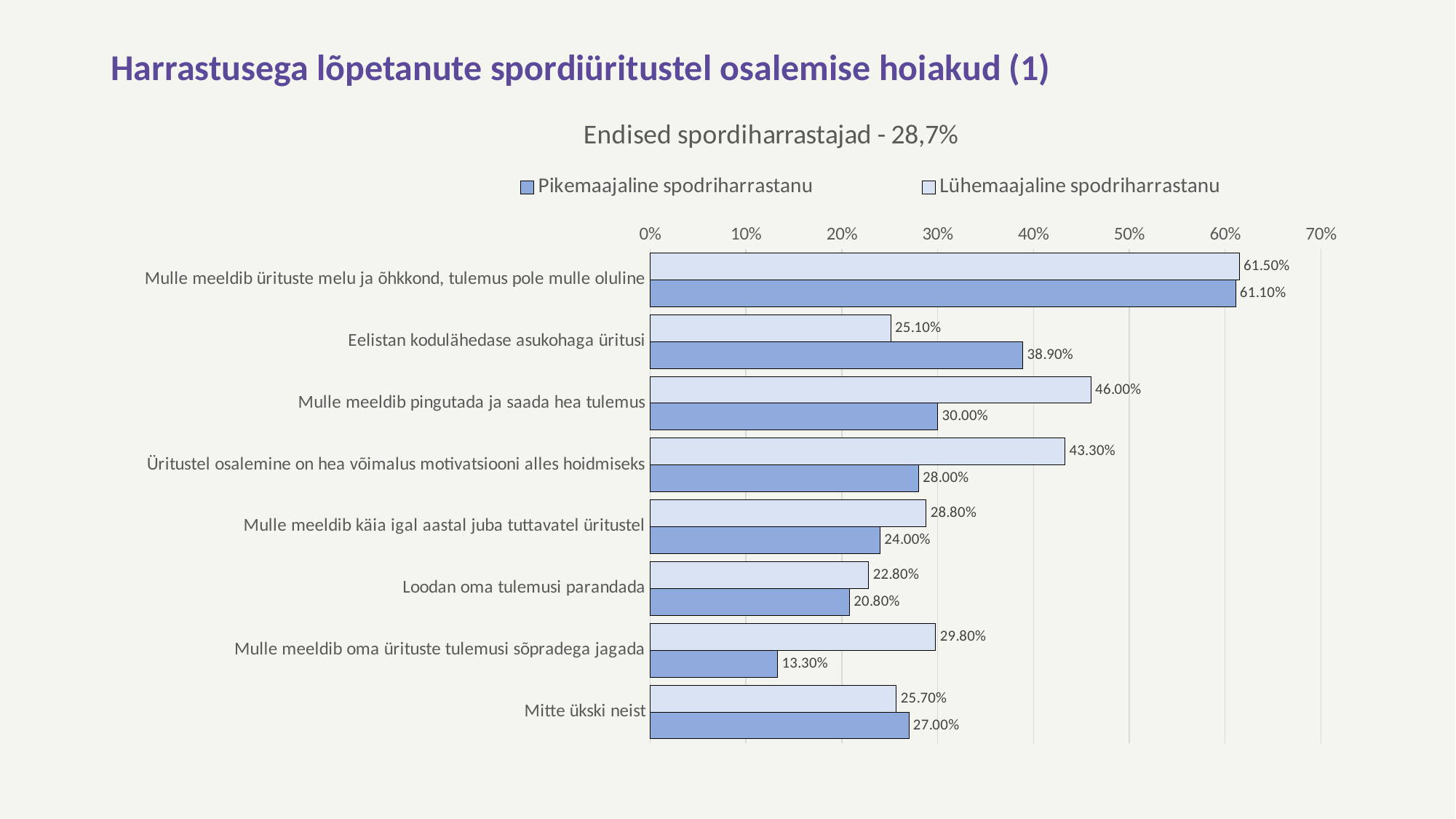
What is the title of the chart? Endised spordiharrastajad - 28,7% What is the value for 'Pikemaajaline spodriharrastanu' in the category 'Eelistan kodulähedase asukohaga üritusi'? 38.90% How many categories are shown on the chart? 8 Which category has the highest value for 'Lühemaajaline spodriharrastanu'? Mulle meeldib ürituste melu ja õhkkond, tulemus pole mulle oluline What is the value for 'Lühemaajaline spodriharrastanu' in the category 'Mulle meeldib pingutada ja saada hea tulemus'? 46.00% What type of chart is shown on the slide? bar chart Which category has the lowest value for 'Pikemaajaline spodriharrastanu'? Mulle meeldib oma ürituste tulemusi sõpradega jagada How many series does the legend list? 2 What is the difference between the 'Lühemaajaline spodriharrastanu' and 'Pikemaajaline spodriharrastanu' values for 'Üritustel osalemine on hea võimalus motivatsiooni alles hoidmiseks'? 15.30% Is the 'Lühemaajaline spodriharrastanu' value for 'Loodan oma tulemusi parandada' greater or less than 30%? less For 'Mitte ükski neist', which series has the larger value: 'Pikemaajaline spodriharrastanu' or 'Lühemaajaline spodriharrastanu'? Pikemaajaline spodriharrastanu What is the value for 'Pikemaajaline spodriharrastanu' in the category 'Mulle meeldib oma ürituste tulemusi sõpradega jagada'? 13.30%